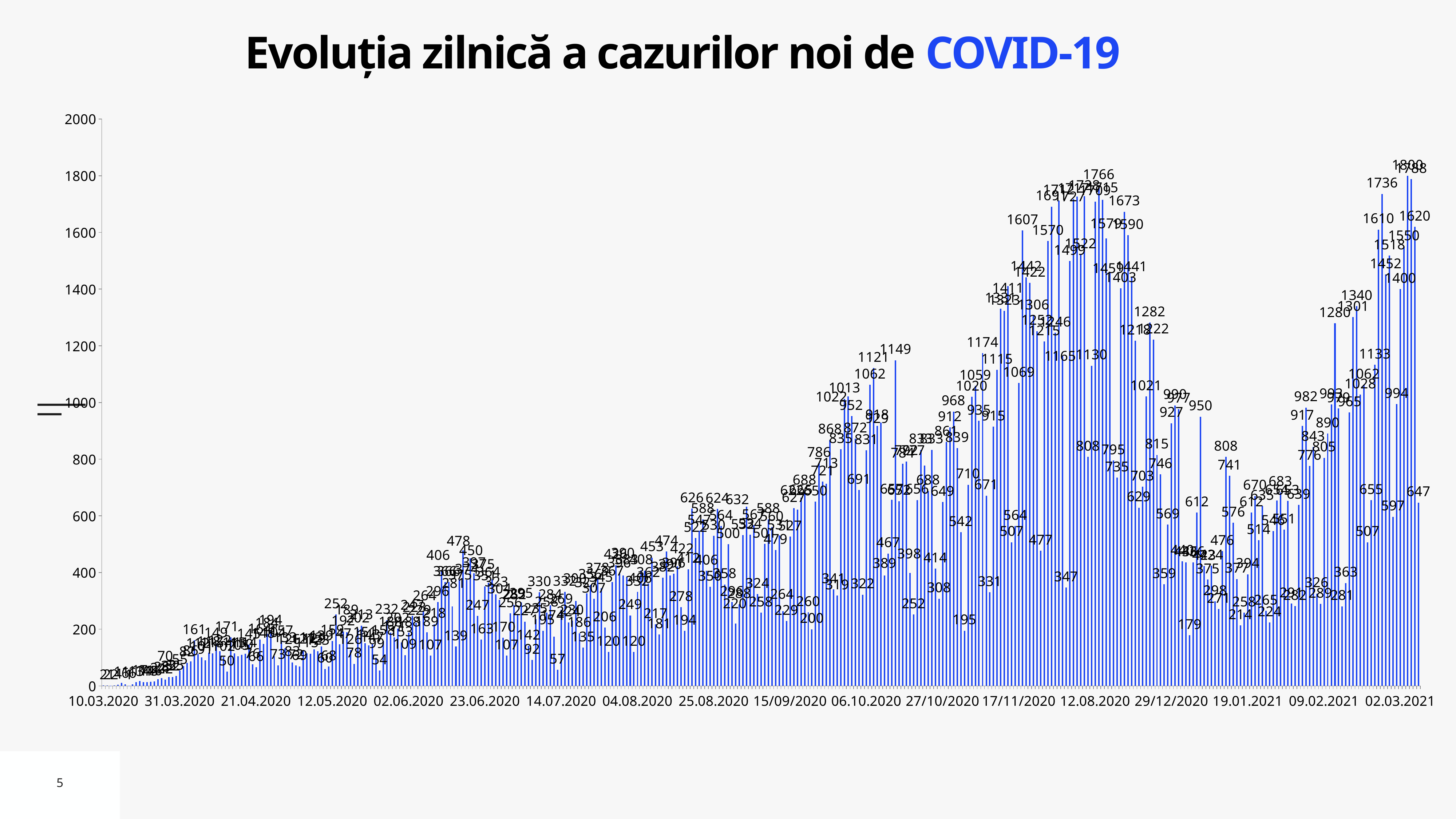
How many date labels are shown on the x axis? 18 What is the highest value labelled in the June 2020 peak of the chart? 478 Is the value for 17/11/2020 greater or less than 1000? greater Which is larger, the value at 10.03.2020 or the value at 02.03.2021? 02.03.2021 What is the title of the chart? Evoluția zilnică a cazurilor noi de COVID-19 What kind of chart is shown on the slide? bar chart Overall, do the values rise or fall from 10.03.2020 to 02.03.2021? rise Is the value for 12.05.2020 greater or less than 400? less What is the highest value labelled in the November 2020 peak of the chart? 1766 What is the highest value shown on the y axis? 2000 What is the difference between the November 2020 peak value (1766) and the June 2020 peak value (478)? 1288